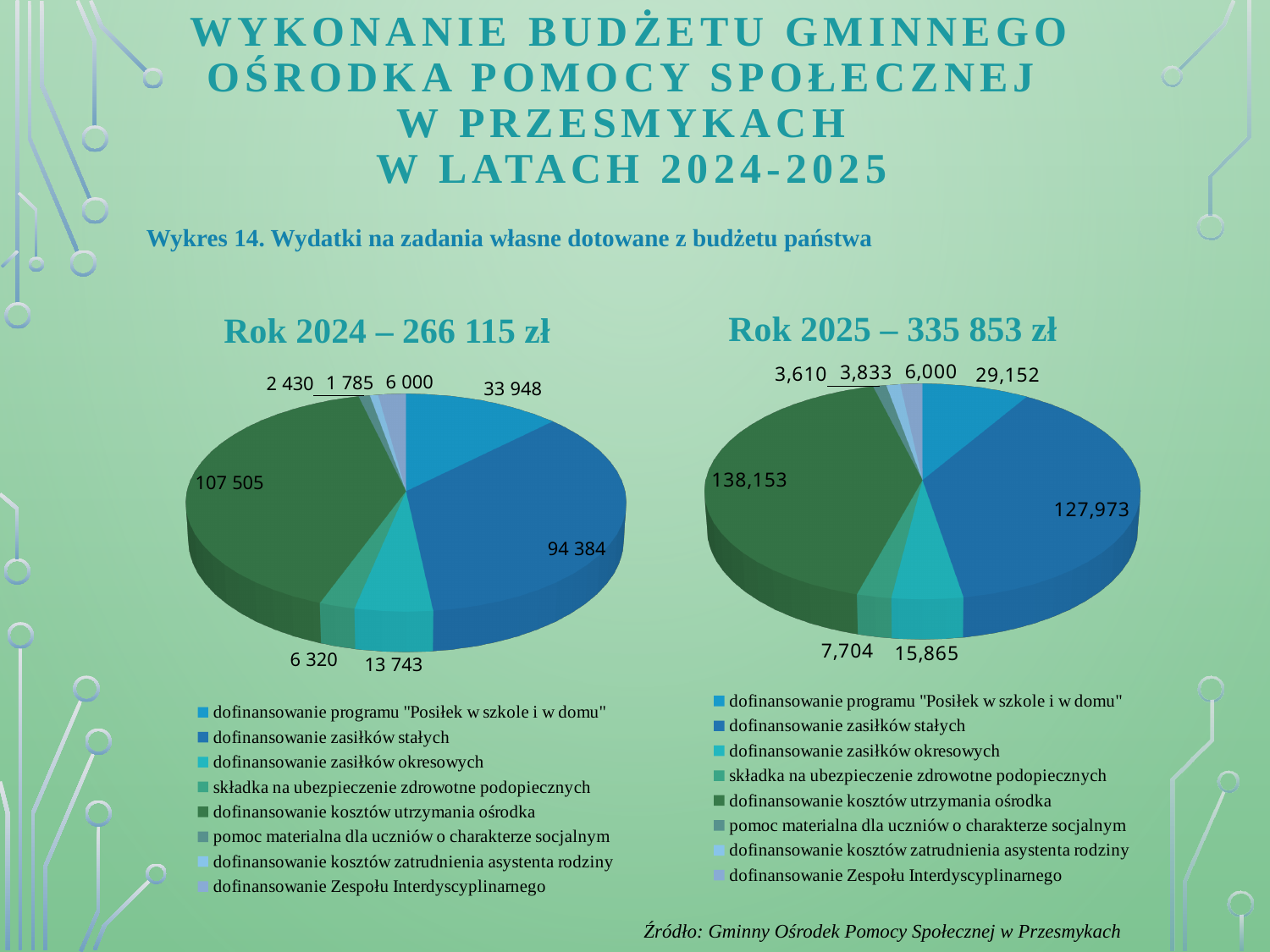
In the Rok 2024 pie chart, which category has the smallest slice? dofinansowanie kosztów zatrudnienia asystenta rodziny In the Rok 2025 pie chart, what is the value for dofinansowanie programu "Posiłek w szkole i w domu"? 29,152 How many slices does the Rok 2025 pie chart have? 8 What total amount is shown in the title of the Rok 2025 chart? 335 853 zł In the Rok 2024 pie chart, which category has the largest slice? dofinansowanie kosztów utrzymania ośrodka In the Rok 2025 pie chart, what is the value for dofinansowanie kosztów utrzymania ośrodka? 138,153 In the Rok 2024 pie chart, what is the difference between dofinansowanie kosztów utrzymania ośrodka and dofinansowanie zasiłków stałych? 13 121 In the Rok 2025 pie chart, which category has the smallest value? pomoc materialna dla uczniów o charakterze socjalnym In the Rok 2024 pie chart, what is the value for dofinansowanie zasiłków stałych? 94 384 In the Rok 2025 pie chart, what is the difference between dofinansowanie kosztów utrzymania ośrodka and dofinansowanie zasiłków stałych? 10,180 What type of chart is used for Rok 2024? pie chart In the Rok 2024 pie chart, which is larger: dofinansowanie zasiłków okresowych or składka na ubezpieczenie zdrowotne podopiecznych? dofinansowanie zasiłków okresowych